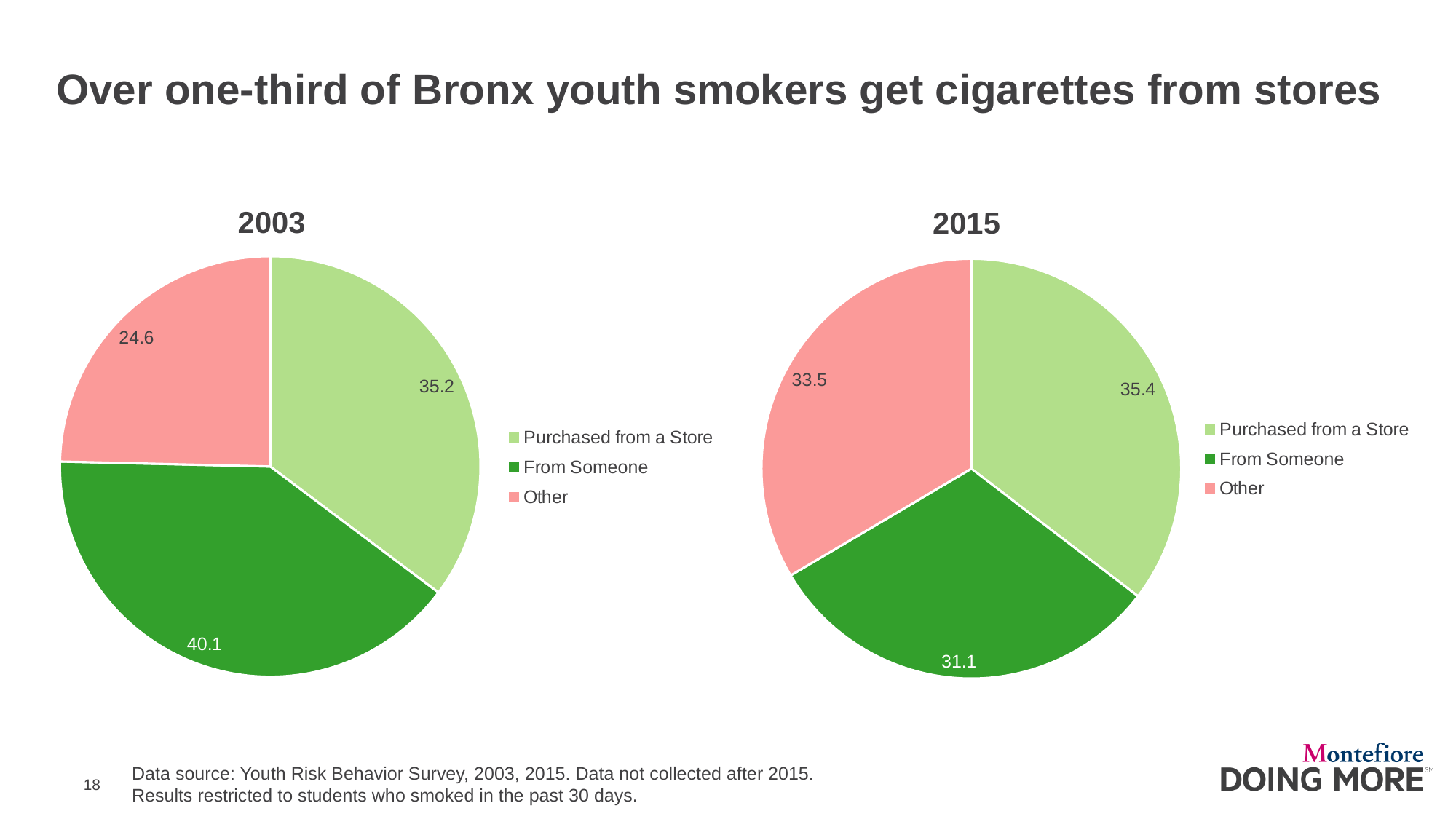
In the 2003 pie chart, which category has the smallest slice? Other In the 2015 pie chart, what is the difference between the Purchased from a Store value and the From Someone value? 4.3 In the 2003 pie chart, which category has the largest slice? From Someone In the 2003 pie chart, what is the value for Other? 24.6 In the 2003 pie chart, what is the difference between the From Someone value and the Other value? 15.5 Is the From Someone value larger in the 2003 pie chart or the 2015 pie chart? 2003 In the 2015 pie chart, what is the value for From Someone? 31.1 In the 2003 pie chart, what is the value for Purchased from a Store? 35.2 How many slices does the 2015 pie chart have? 3 In the 2015 pie chart, what is the value for Other? 33.5 In the 2015 pie chart, which category has the smallest slice? From Someone What type of chart is used for the 2003 data? Pie chart